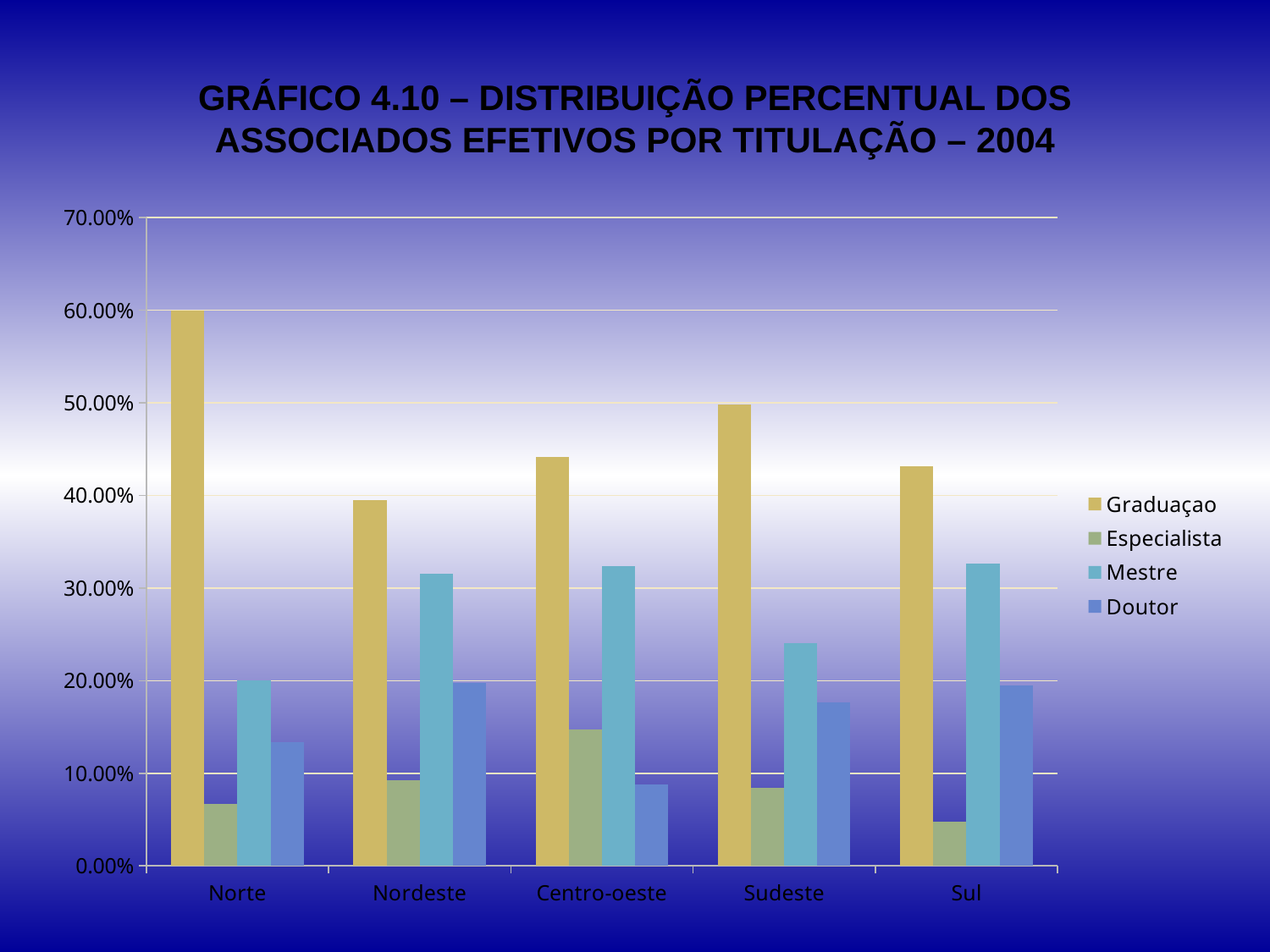
Which region has the highest value for Graduaçao? Norte Is the value for Mestre in Sudeste greater or less than 30.00%? less How many regions (categories) are shown on the x axis? 5 What kind of chart is shown on the slide? bar chart Is the value for Mestre in Nordeste greater or less than 30.00%? greater Is the value for Graduaçao in Centro-oeste greater or less than 40.00%? greater How many series does the legend list? 4 Which region has the lowest value for Graduaçao? Nordeste Which region has the lowest value for Doutor? Centro-oeste What is the value for Graduaçao in Norte? 60.00% Which region has the highest value for Especialista? Centro-oeste Which is larger, the Mestre value for Centro-oeste or the Mestre value for Sudeste? Centro-oeste